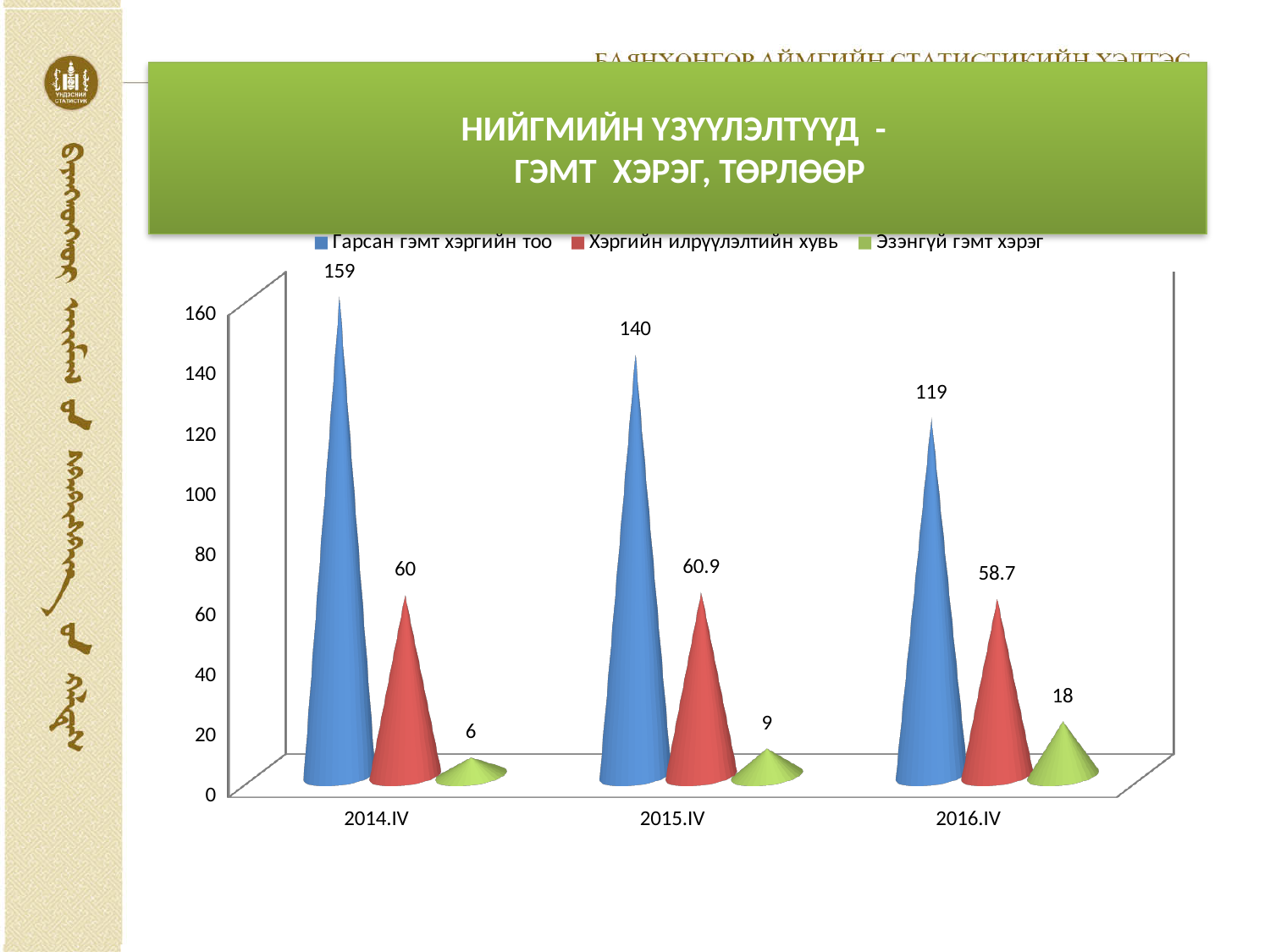
What is the difference between Гарсан гэмт хэргийн тоо in 2014.IV and 2016.IV? 40 How many periods are shown on the x axis? 3 In which period is Эзэнгүй гэмт хэрэг the highest? 2016.IV What is the value of Эзэнгүй гэмт хэрэг for 2016.IV? 18 How many series does the legend list? 3 Does Гарсан гэмт хэргийн тоо rise or fall from 2014.IV to 2016.IV? Fall What is the value of Хэргийн илрүүлэлтийн хувь for 2015.IV? 60.9 What kind of chart is shown on the slide? Bar chart In which period is Гарсан гэмт хэргийн тоо the lowest? 2016.IV What is the value of Гарсан гэмт хэргийн тоо for 2014.IV? 159 What colour represents Эзэнгүй гэмт хэрэг in the legend? Green Which is larger: Хэргийн илрүүлэлтийн хувь in 2015.IV or in 2016.IV? 2015.IV